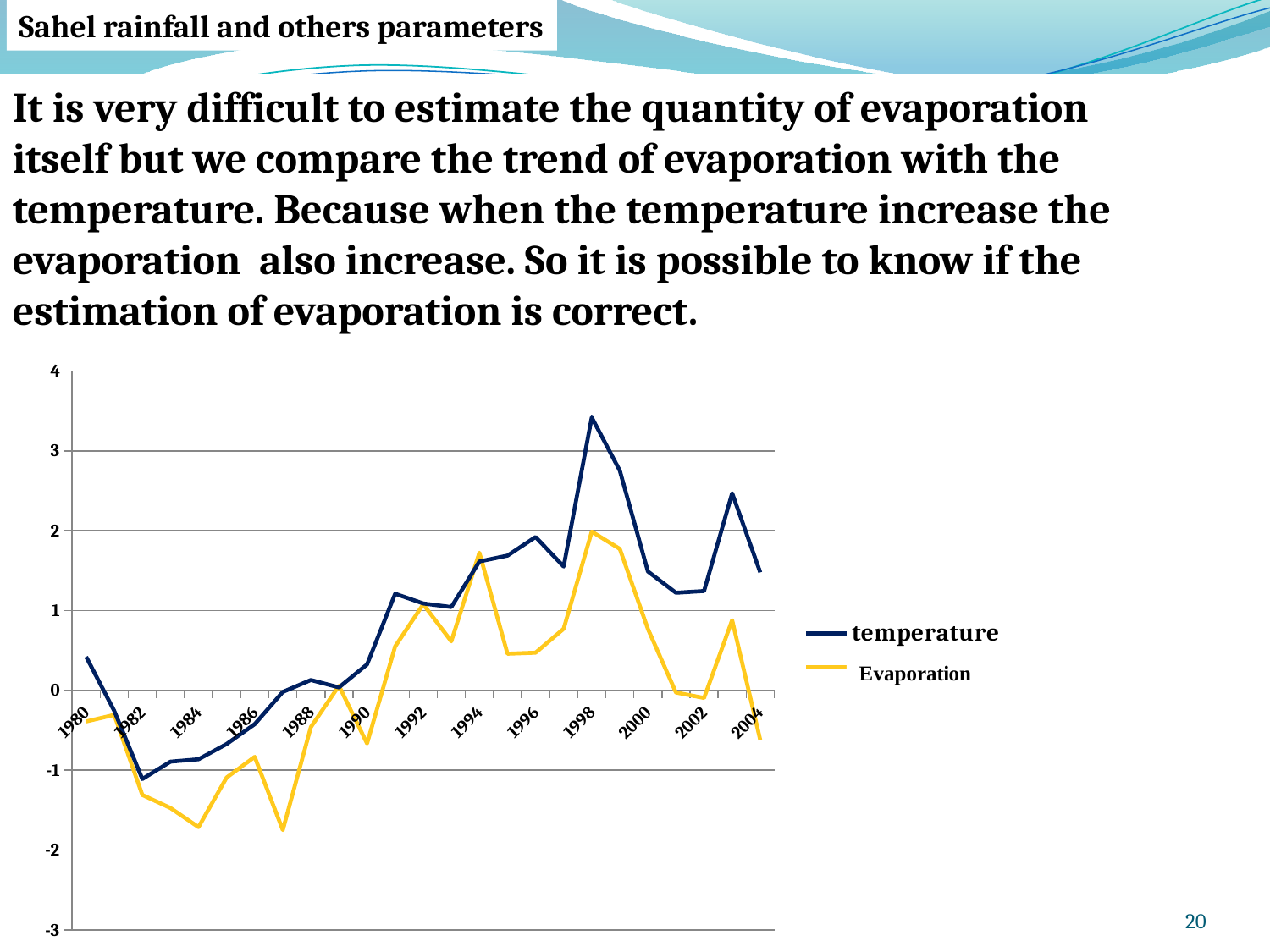
What kind of chart is shown on the slide? line chart Is the Evaporation value for 1984 greater or less than -1? less Overall, does the temperature line rise or fall from 1980 to 2004? rise How many series does the chart legend list? 2 In which labelled year does the temperature line reach its lowest value? 1982 In 1998, which series has the higher value, temperature or Evaporation? temperature Is the temperature value for 1998 greater or less than 3? greater Which colour is used for the Evaporation line? yellow In which labelled year does the temperature line reach its highest value? 1998 What are the two series named in the chart legend? temperature and Evaporation In which labelled year does the Evaporation line reach its highest value? 1998 Is the Evaporation value for 2004 greater or less than 0? less